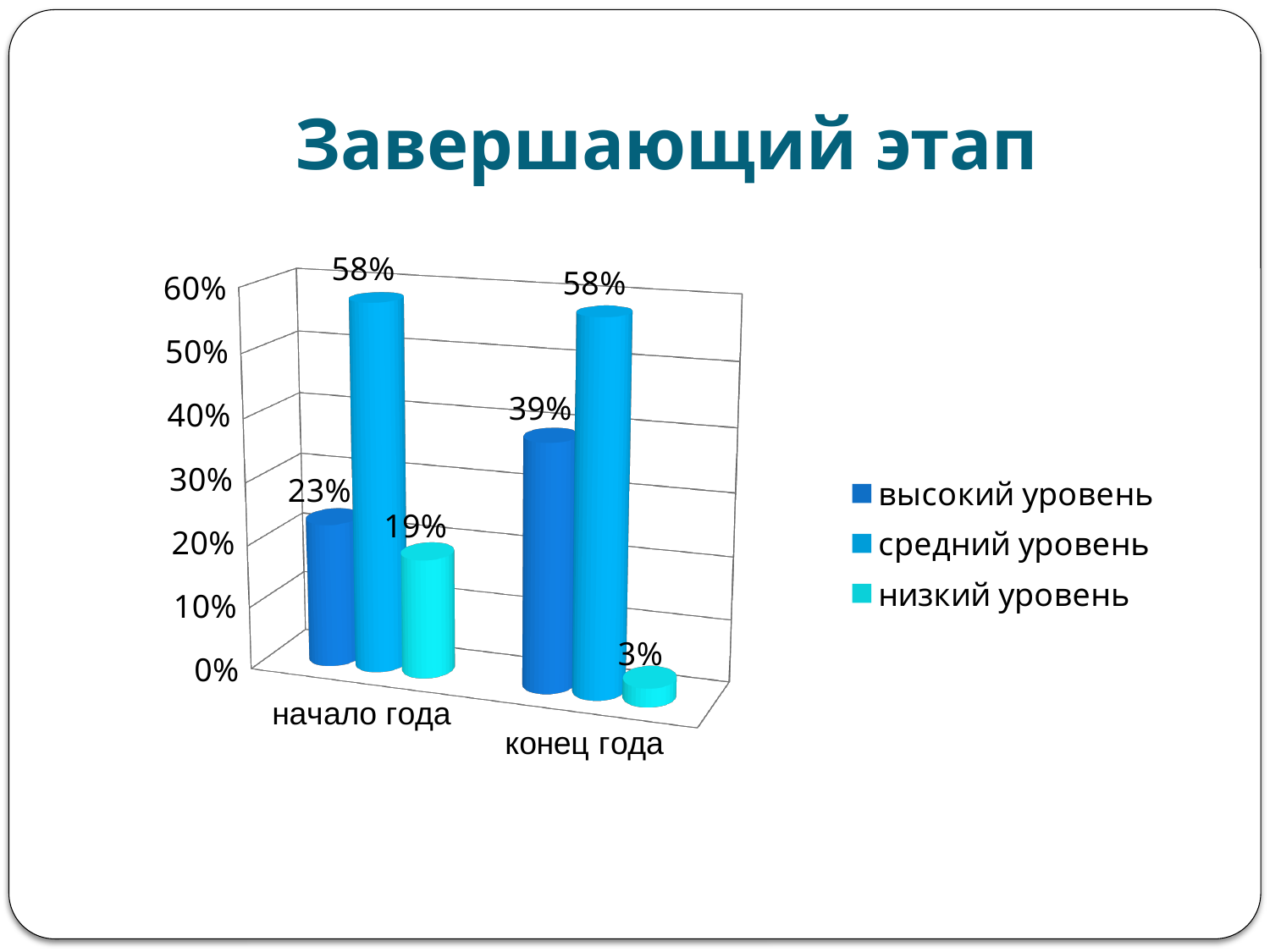
What is the value for низкий уровень at конец года? 3% What kind of chart is shown on the slide? bar chart What is the value for средний уровень at конец года? 58% How many series does the legend list? 3 Which series has the lowest value at конец года? низкий уровень What is the title of the slide? Завершающий этап Which series has the highest value at начало года? средний уровень How many categories are shown on the x axis? 2 Which is larger: низкий уровень at начало года or низкий уровень at конец года? начало года What is the value for высокий уровень at начало года? 23% What is the value for низкий уровень at начало года? 19% What is the difference between высокий уровень at конец года and at начало года? 16%